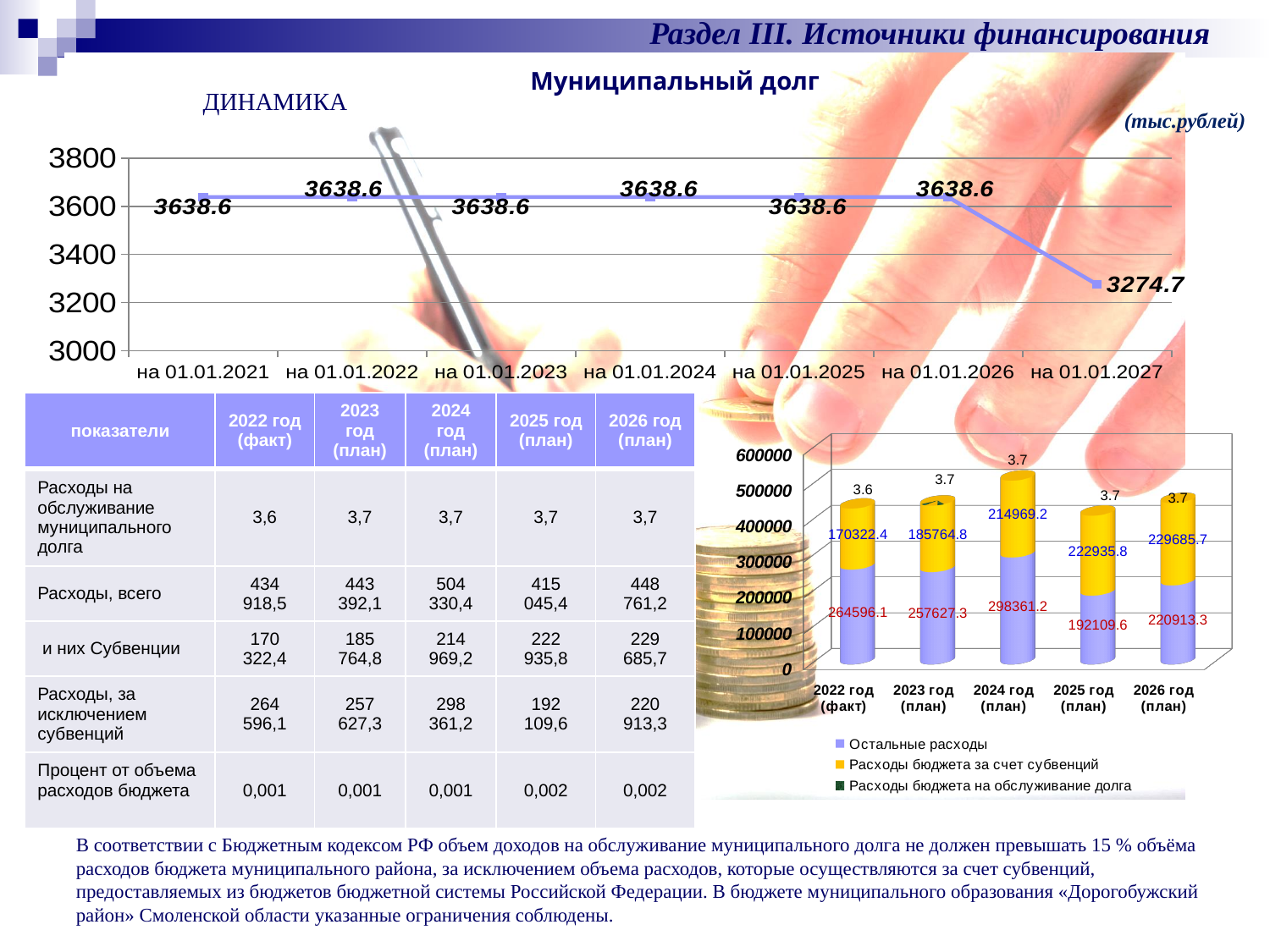
In the stacked bar chart at the bottom right, which year has the lowest value for 'Остальные расходы'? 2025 год (план) In the stacked bar chart at the bottom right, what is the value of 'Расходы бюджета за счет субвенций' for 2026 год (план)? 229685.7 In the stacked bar chart at the bottom right, what is the value of 'Остальные расходы' for 2024 год (план)? 298361.2 In the line chart 'Муниципальный долг', how many dates are plotted on the x axis? 7 In the line chart 'Муниципальный долг', which date has the lowest value? на 01.01.2027 In the line chart 'Муниципальный долг', what is the value for на 01.01.2024? 3638.6 How many series does the legend of the stacked bar chart at the bottom right list? 3 In the stacked bar chart at the bottom right, what is the difference between 'Расходы бюджета за счет субвенций' for 2024 год (план) and for 2022 год (факт)? 44646.8 In the line chart 'Муниципальный долг', what is the value for на 01.01.2027? 3274.7 In the stacked bar chart at the bottom right, which year has the highest value for 'Расходы бюджета за счет субвенций'? 2026 год (план) In the line chart 'Муниципальный долг', do the values rise, fall or stay flat from на 01.01.2021 to на 01.01.2026? stay flat In the line chart 'Муниципальный долг', what is the difference between the value for на 01.01.2026 and the value for на 01.01.2027? 363.9